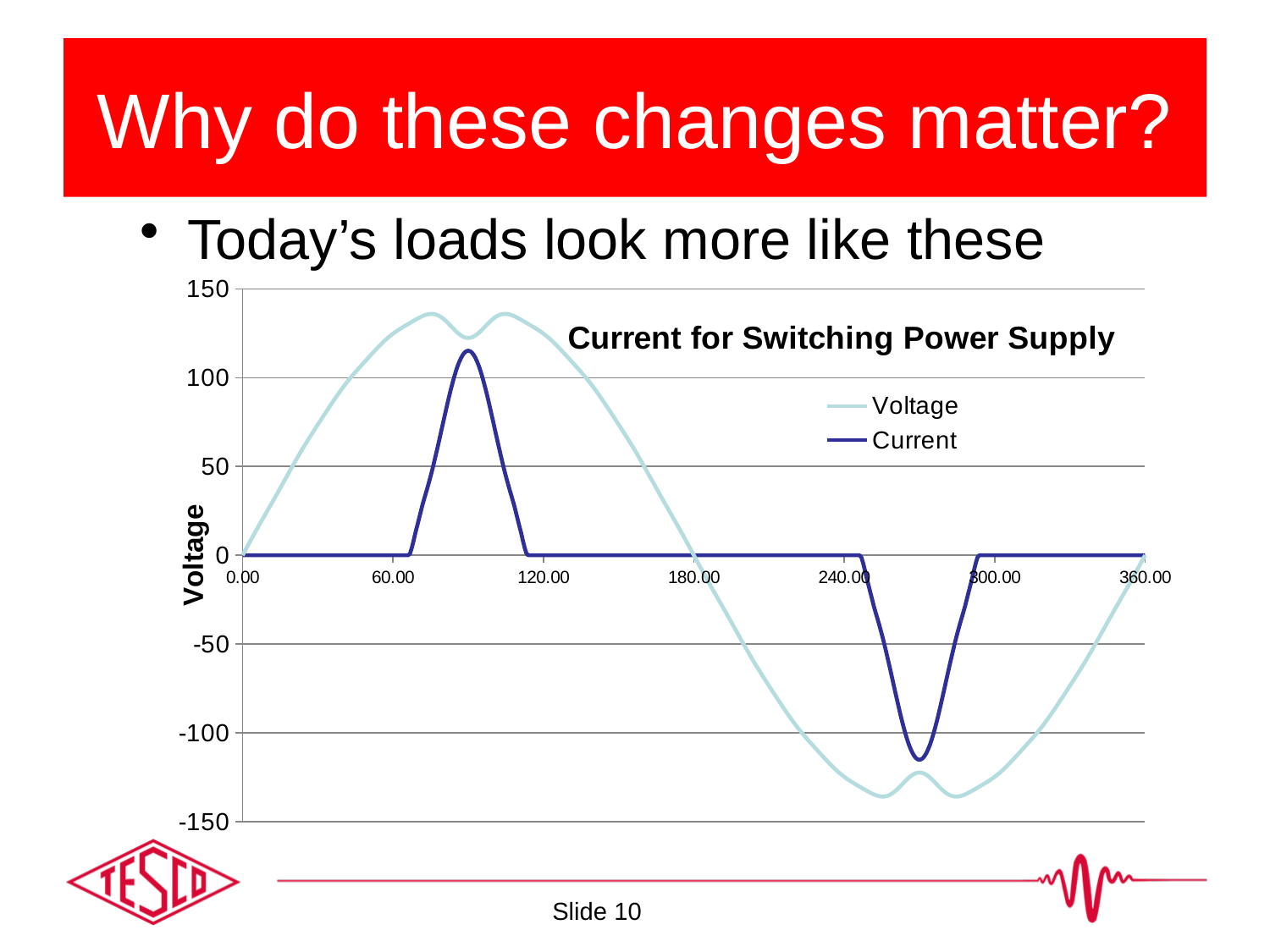
Does the Voltage series rise or fall between 120.00 and 180.00 on the x axis? fall What is the title of the chart? Current for Switching Power Supply What kind of chart is shown on the slide? line chart Which series is drawn in the dark blue line? Current Is the peak value of the Voltage series greater or less than 100? greater How many series does the chart legend list? 2 Which series reaches a higher peak value, Voltage or Current? Voltage Which series reaches a lower minimum value, Voltage or Current? Voltage Is the Current value at 30.00 on the x axis greater or less than 50? less Does the Voltage series rise or fall between 0.00 and 60.00 on the x axis? rise Is the peak value of the Current series greater or less than 100? greater